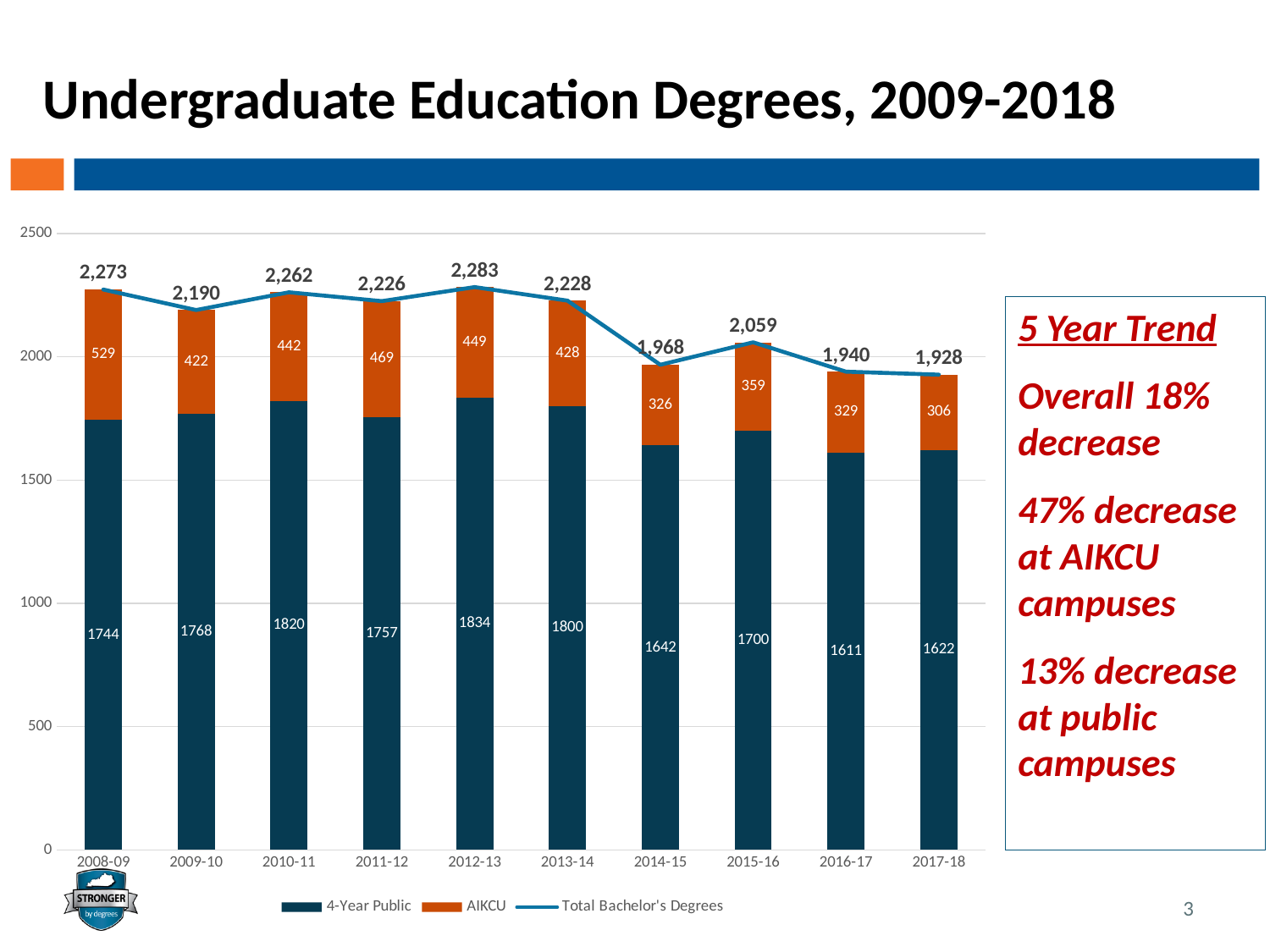
What kind of chart is shown? Stacked bar chart with a line What is the difference between the AIKCU values for 2008-09 and 2017-18? 223 How many academic years are shown on the x axis? 10 What is the Total Bachelor's Degrees value for 2015-16? 2,059 How many series does the legend list? 3 Which year has the highest Total Bachelor's Degrees? 2012-13 Which year has the lowest AIKCU value? 2017-18 Is the Total Bachelor's Degrees value for 2014-15 greater or less than 2000? less What is the AIKCU value for 2017-18? 306 What is the total of the stacked bar for 2016-17? 1,940 What is the value for 4-Year Public in 2012-13? 1834 Which is larger, the 4-Year Public value for 2010-11 or for 2011-12? 2010-11